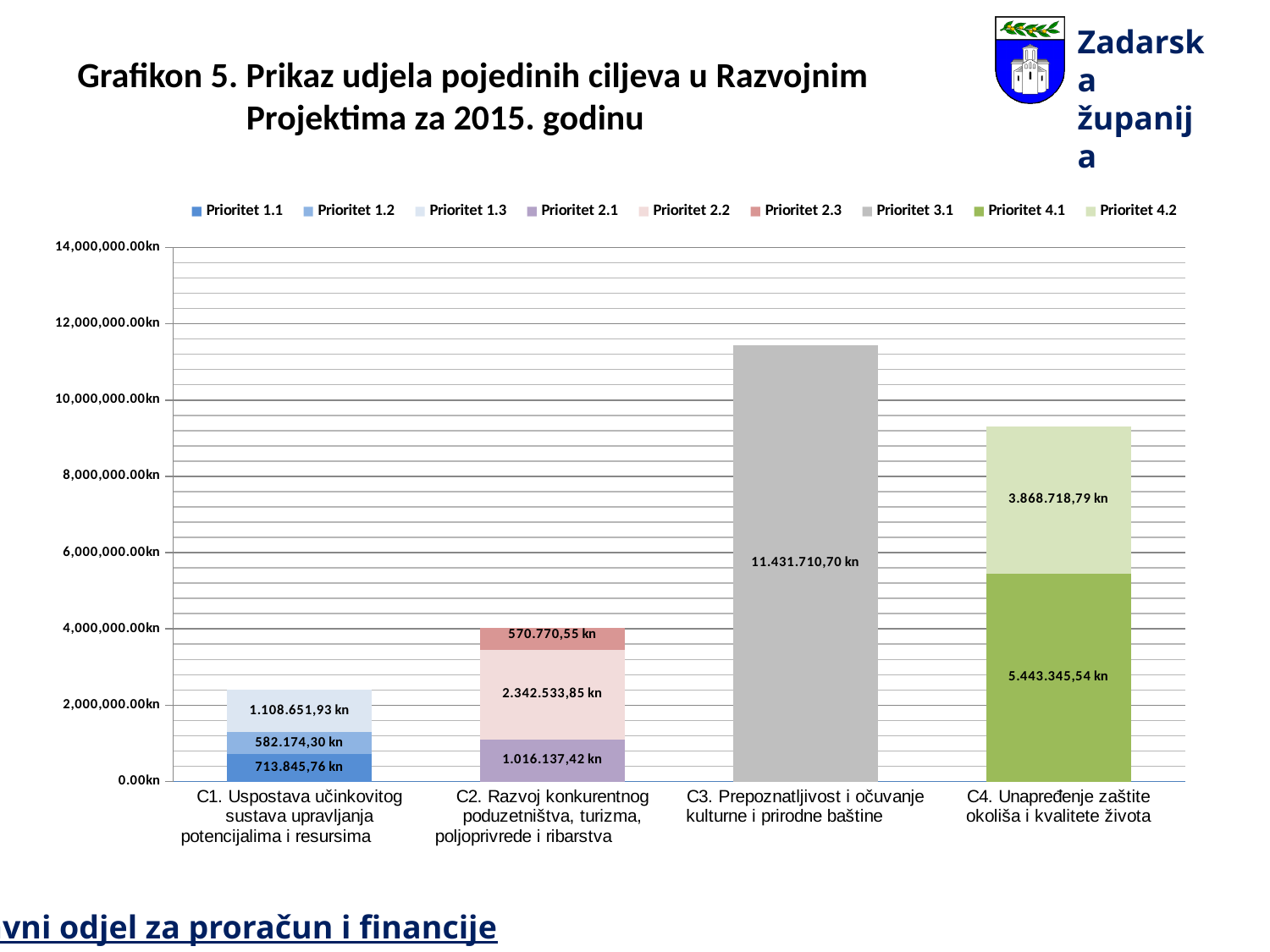
What kind of chart is shown on the slide? Stacked bar chart How many series does the legend list? 9 What is the value for Prioritet 2.2 in category C2. Razvoj konkurentnog poduzetništva, turizma, poljoprivrede i ribarstva? 2.342.533,85 kn What is the total of the stacked bar for C4. Unapređenje zaštite okoliša i kvalitete života? 9.312.064,33 kn What is the value for Prioritet 4.2 in category C4. Unapređenje zaštite okoliša i kvalitete života? 3.868.718,79 kn What is the difference between Prioritet 4.1 and Prioritet 4.2 in category C4? 1.574.626,75 kn Is the total value for C3. Prepoznatljivost i očuvanje kulturne i prirodne baštine greater or less than 10,000,000.00kn? greater Which is larger in category C4: Prioritet 4.1 or Prioritet 4.2? Prioritet 4.1 Which category has the lowest total bar? C1. Uspostava učinkovitog sustava upravljanja potencijalima i resursima What is the value for Prioritet 3.1 in category C3. Prepoznatljivost i očuvanje kulturne i prirodne baštine? 11.431.710,70 kn Which category has the highest total bar? C3. Prepoznatljivost i očuvanje kulturne i prirodne baštine How many categories are shown on the x axis? 4